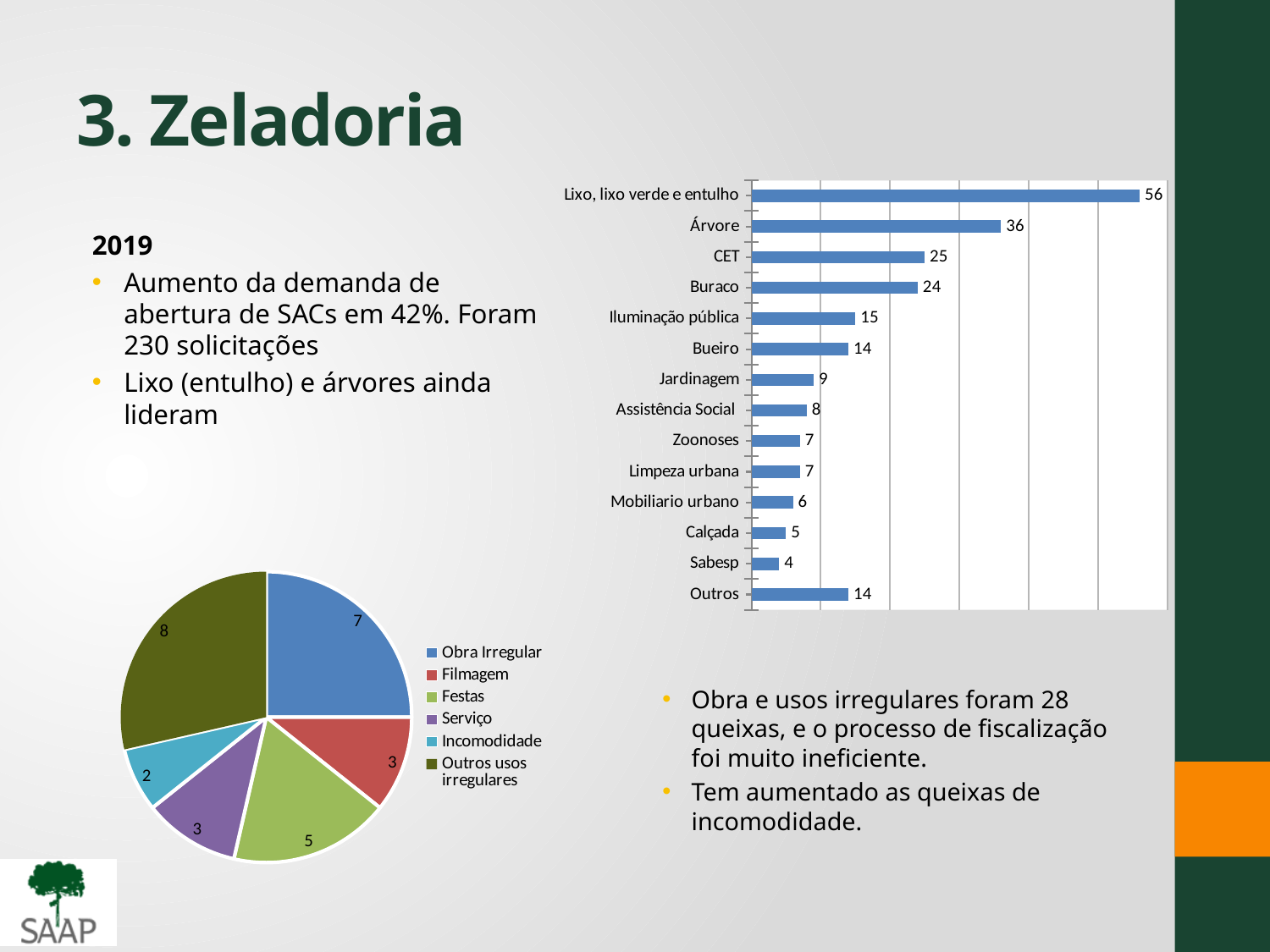
In the pie chart at the bottom left, what is the value for Festas? 5 In the bar chart on the right, what is the difference between the values for CET and Buraco? 1 In the bar chart on the right, what is the value for Iluminação pública? 15 In the bar chart on the right, which category has the highest value? Lixo, lixo verde e entulho In the bar chart on the right, what is the value for Árvore? 36 In the pie chart at the bottom left, what share of the total does Obra Irregular represent? 25% In the bar chart on the right, which category has the lowest value? Sabesp In the bar chart on the right, which is larger, the value for Bueiro or the value for Jardinagem? Bueiro How many categories are shown in the bar chart on the right? 14 How many entries does the legend of the pie chart at the bottom left list? 6 What kind of chart is the chart on the right of the slide? Bar chart In the pie chart at the bottom left, which category has the largest slice? Outros usos irregulares